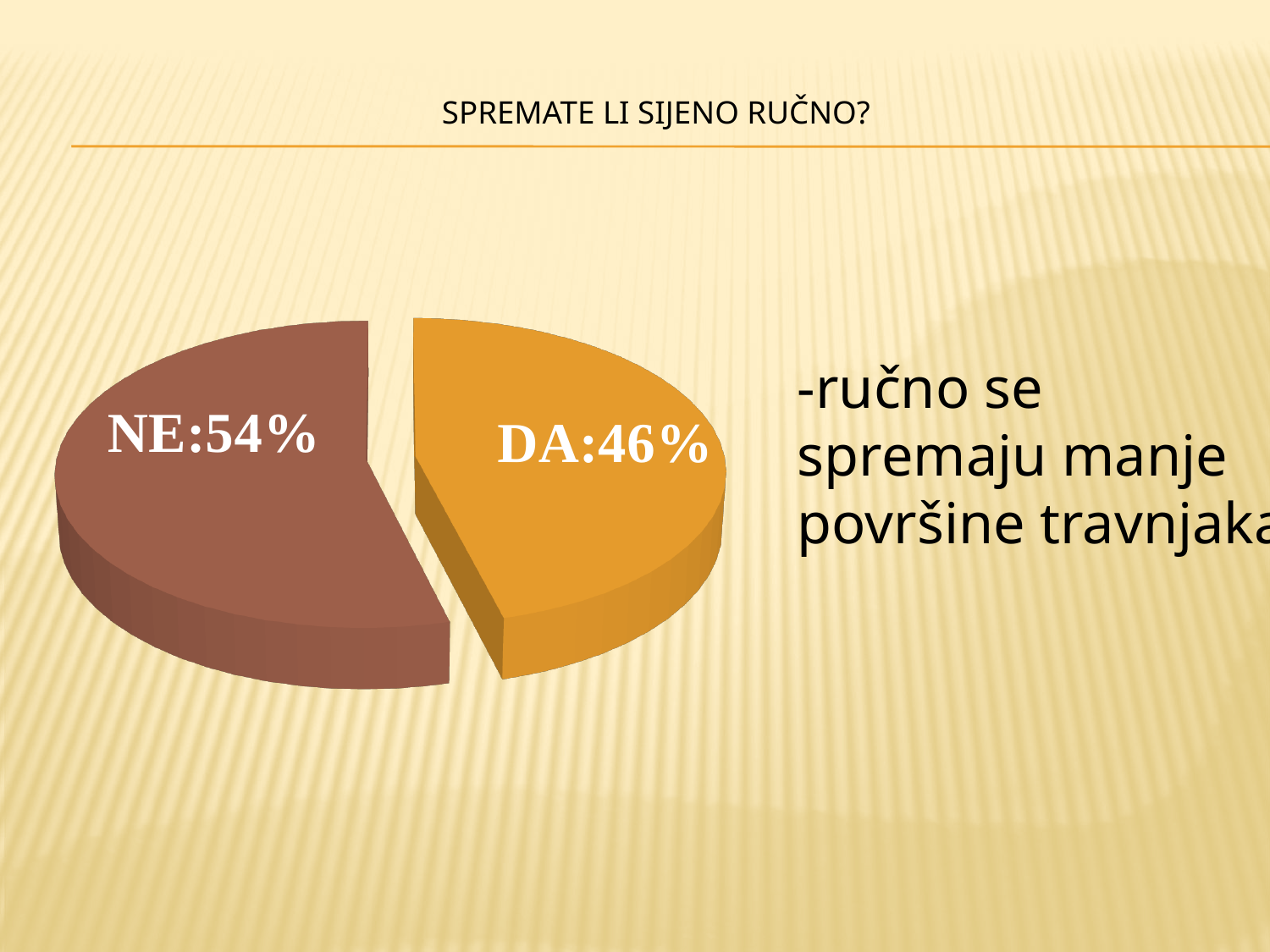
Which slice is the largest? NE Which slice is the smallest? DA What is the title of the slide above the chart? SPREMATE LI SIJENO RUČNO? What is the value for NE? 54% What colour is the DA slice? orange What kind of chart is shown on the slide? pie chart What is the value for DA? 46% Which is larger, NE or DA? NE How many slices does the pie chart have? 2 What is the difference between the NE and DA values? 8% What share of the pie does DA take? 46%